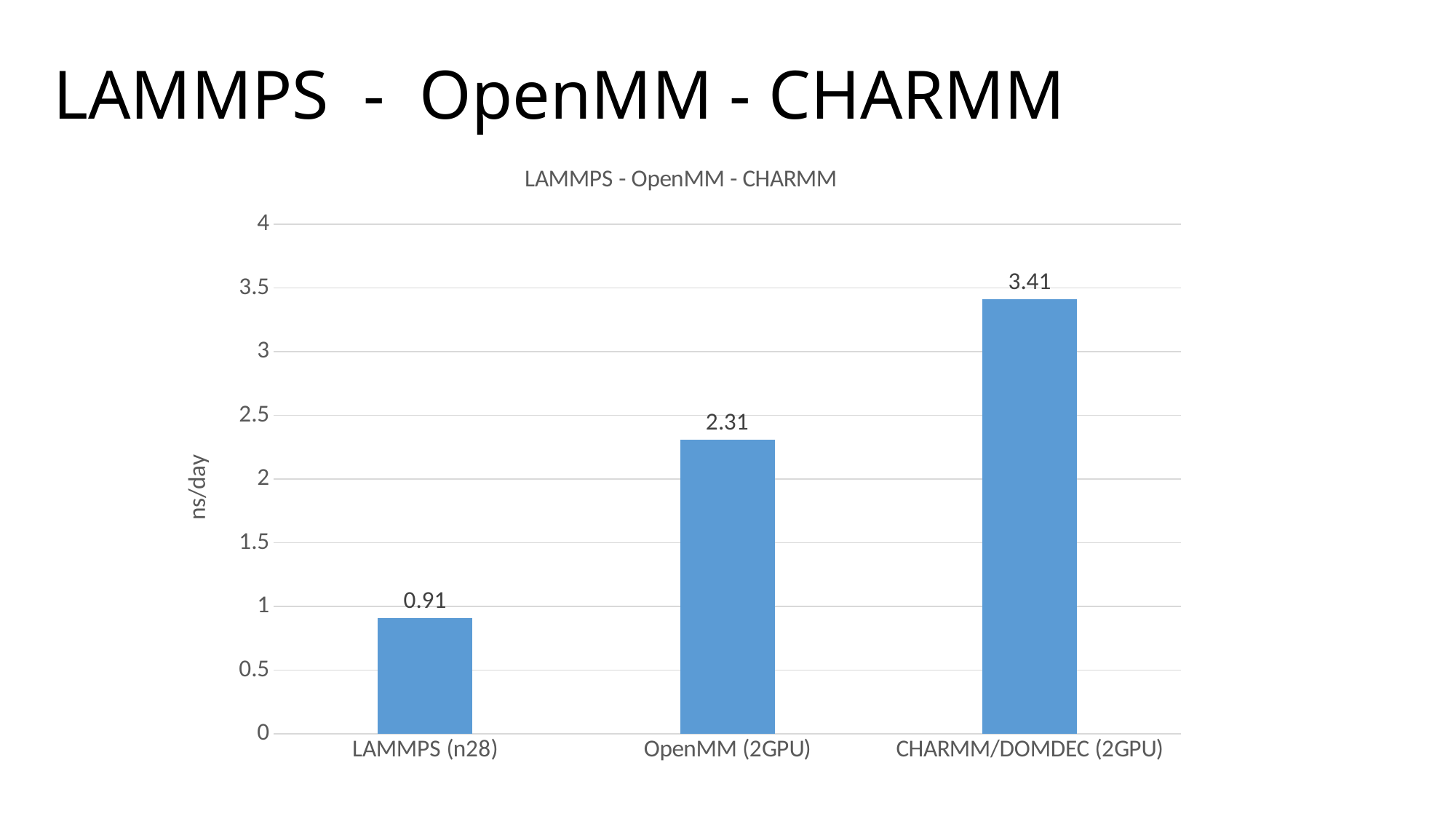
How many categories are shown on the x axis? 3 Which category has the lowest value? LAMMPS (n28) What is the value for OpenMM (2GPU)? 2.31 What is the difference between the values for OpenMM (2GPU) and LAMMPS (n28)? 1.40 Which is larger, the value for OpenMM (2GPU) or the value for LAMMPS (n28)? OpenMM (2GPU) What is the value for LAMMPS (n28)? 0.91 What is the value for CHARMM/DOMDEC (2GPU)? 3.41 Is the value for CHARMM/DOMDEC (2GPU) greater or less than 3? greater What is the difference between the values for CHARMM/DOMDEC (2GPU) and OpenMM (2GPU)? 1.10 What kind of chart is shown on the slide? bar chart Which category has the highest value? CHARMM/DOMDEC (2GPU) What is the label of the y axis? ns/day